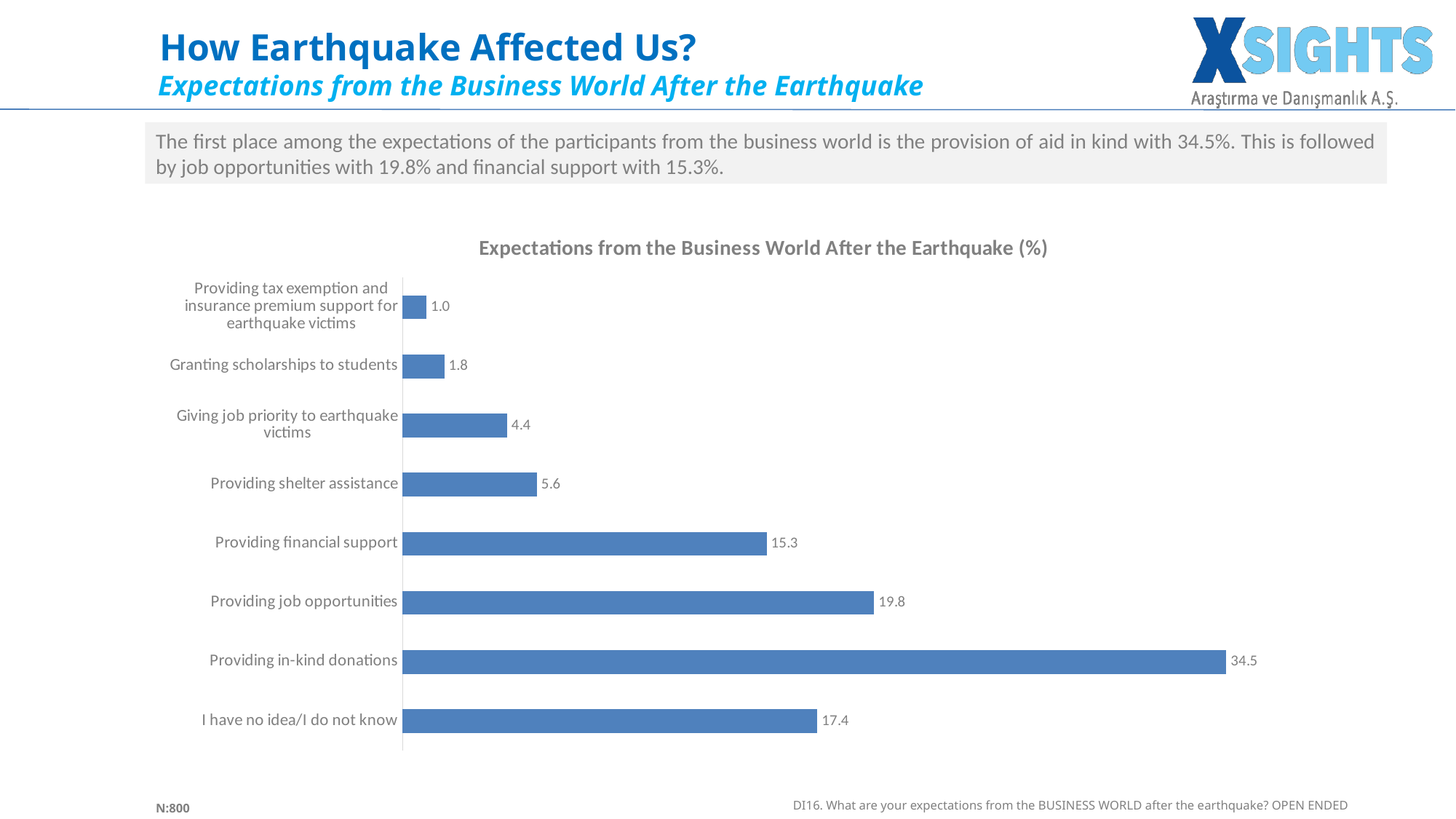
What is the difference between Giving job priority to earthquake victims and Granting scholarships to students? 2.6 What is the value for Providing job opportunities? 19.8 What is the value for Providing shelter assistance? 5.6 What is the difference between Providing in-kind donations and Providing job opportunities? 14.7 Which category has the highest value? Providing in-kind donations How many categories are shown in the chart? 8 Which category has the lowest value? Providing tax exemption and insurance premium support for earthquake victims What is the title of the chart? Expectations from the Business World After the Earthquake (%) Which is larger: Providing financial support or I have no idea/I do not know? I have no idea/I do not know What is the value for I have no idea/I do not know? 17.4 What kind of chart is shown on the slide? Bar chart What is the value for Providing in-kind donations? 34.5